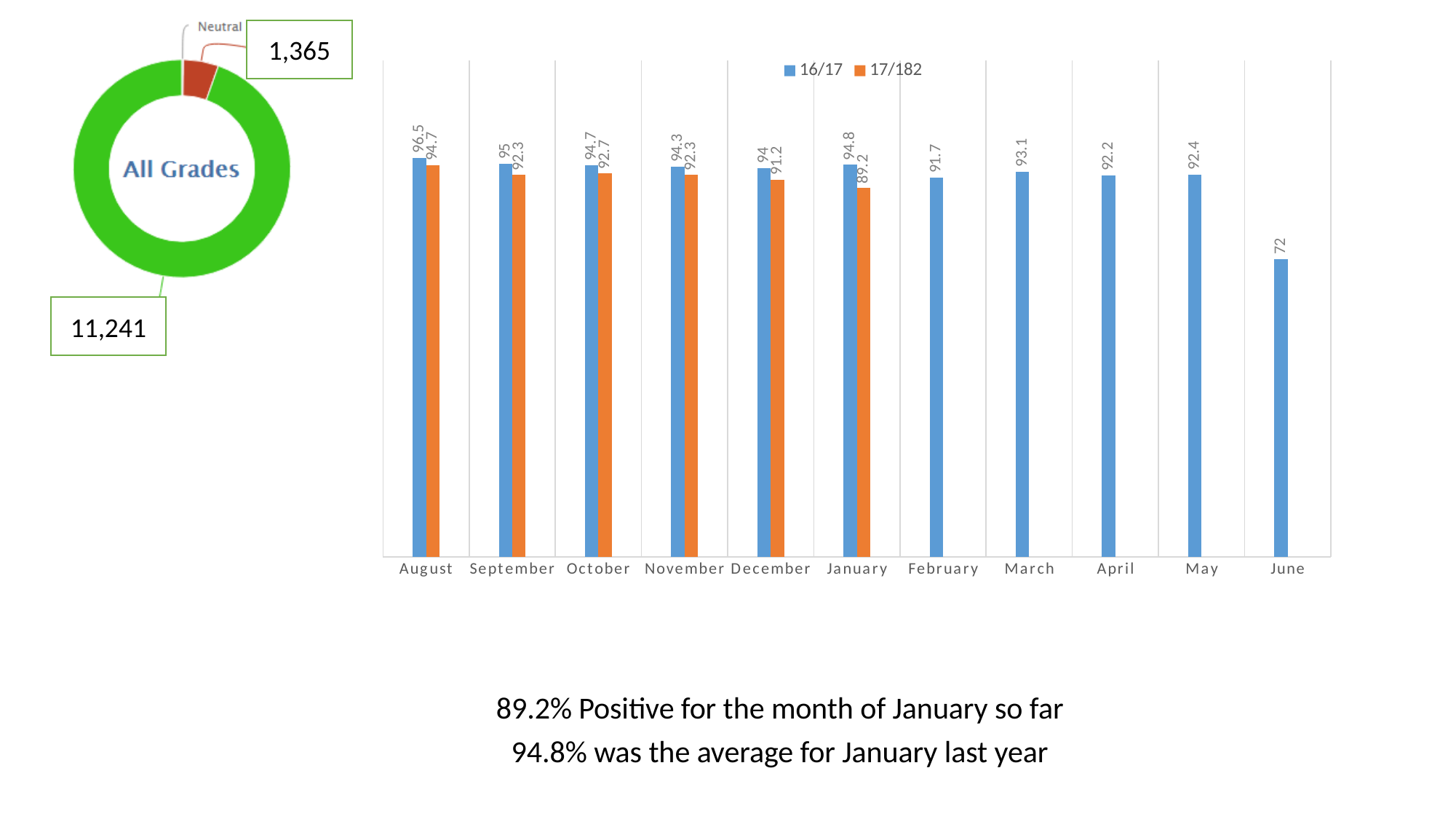
In the bar chart on the right, which series has the larger value for October, 16/17 or 17/182? 16/17 In the bar chart on the right, how many months are shown on the x axis? 11 In the donut chart on the left, what is the value of the green slice? 11,241 In the bar chart on the right, how many series does the legend list? 2 What kind of chart is the chart on the right showing monthly values? Bar chart In the bar chart on the right, what is the 16/17 value for August? 96.5 In the bar chart on the right, how many months have a 17/182 bar? 6 In the bar chart on the right, what is the difference between the 16/17 and 17/182 values for January? 5.6 In the bar chart on the right, what is the 17/182 value for January? 89.2 In the donut chart on the left, what is the value of the Neutral slice? 1,365 In the bar chart on the right, which month has the lowest 16/17 value? June In the bar chart on the right, which month has the highest 16/17 value? August